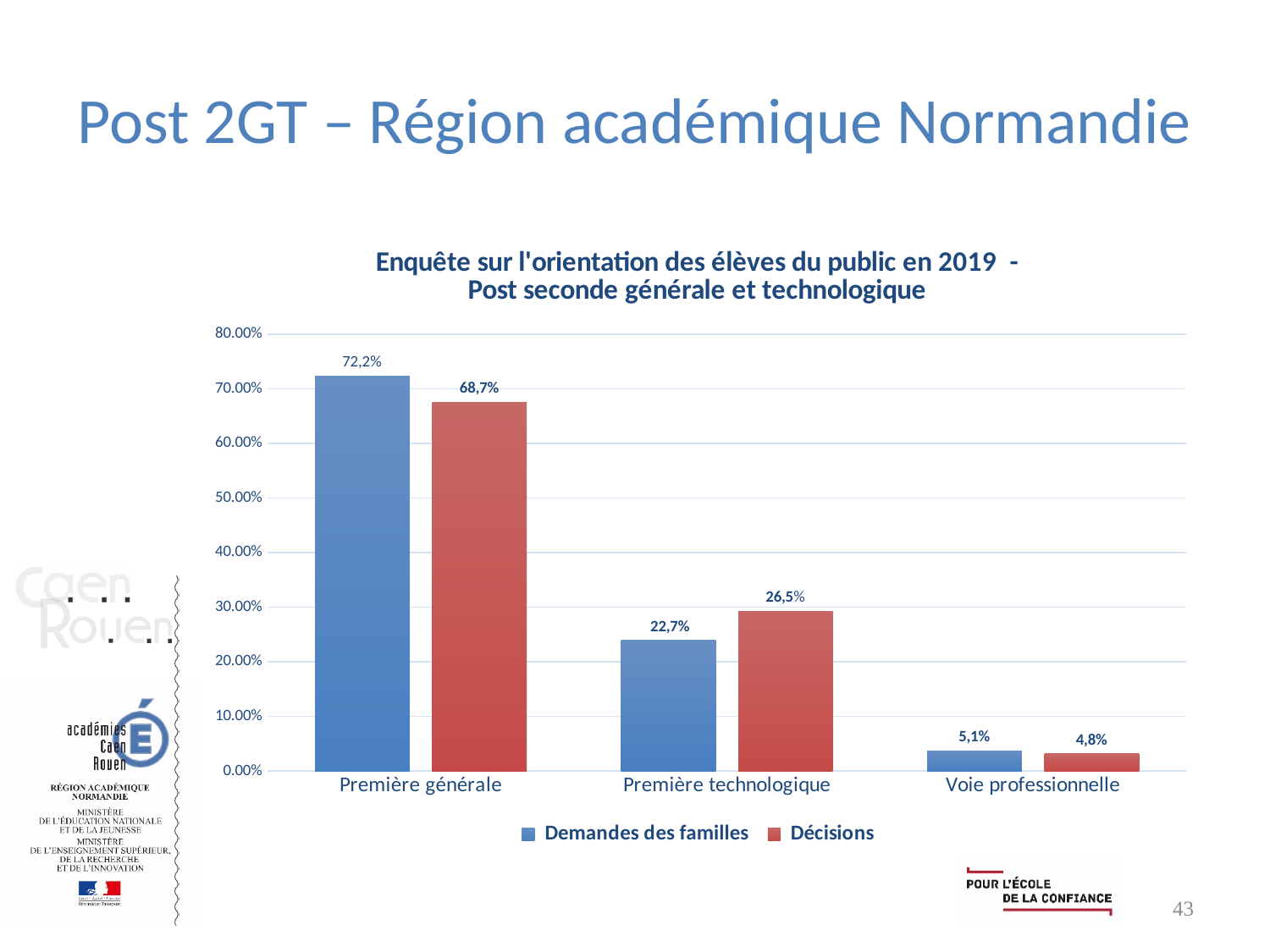
What kind of chart is shown on the slide? Bar chart For Première technologique, which is larger: Demandes des familles or Décisions? Décisions How many categories are shown on the x axis? 3 Which category has the highest value for Demandes des familles? Première générale What is the value of Décisions for Voie professionnelle? 4,8% Is the value of Décisions for Première générale greater or less than 60.00%? greater What is the difference between Décisions and Demandes des familles for Première technologique? 3,8 percentage points What is the value of Demandes des familles for Première générale? 72,2% What is the value of Décisions for Première technologique? 26,5% How many series does the legend list? 2 What is the difference between Demandes des familles and Décisions for Première générale? 3,5 percentage points Which category has the lowest value for Décisions? Voie professionnelle